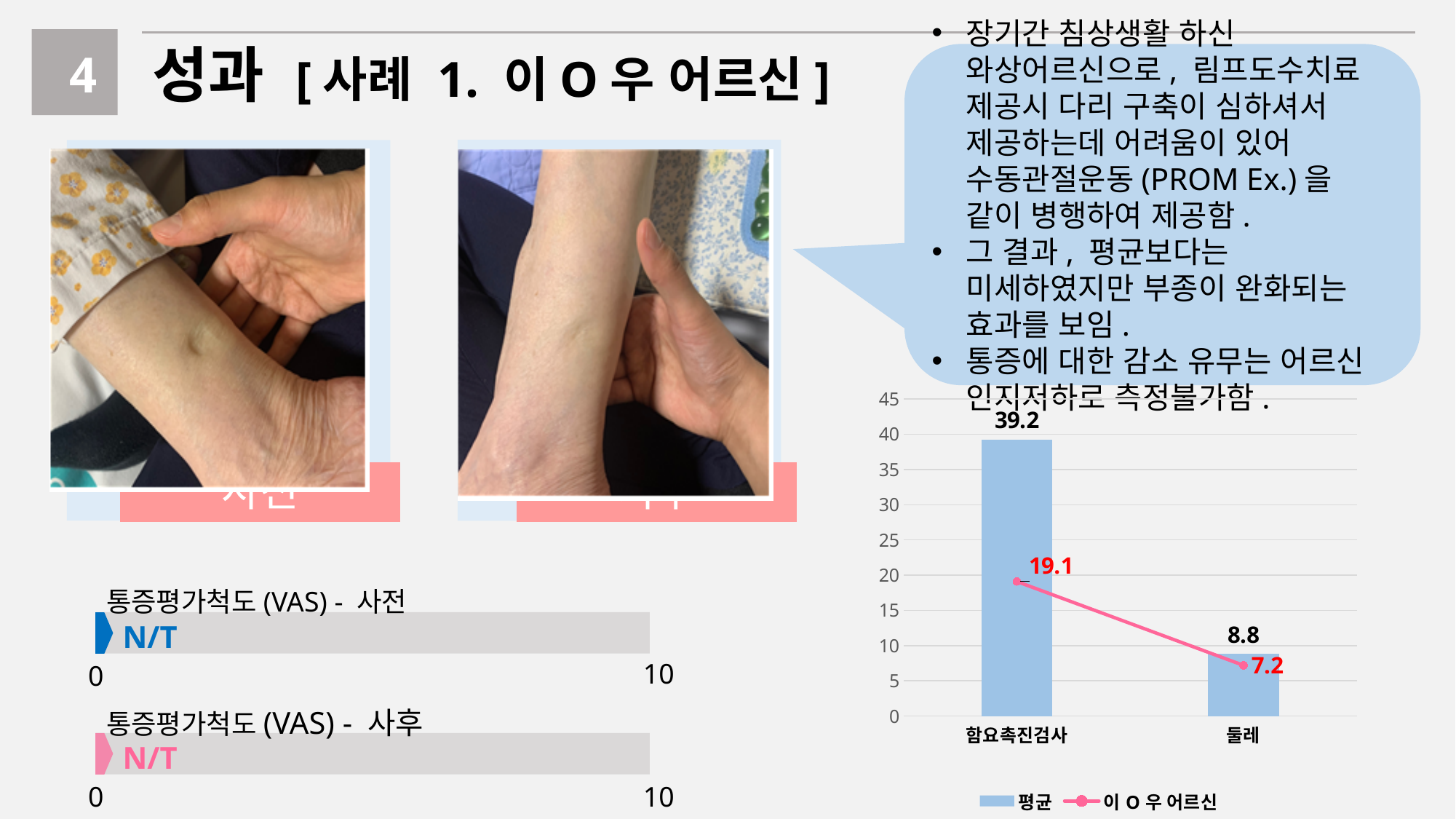
In the chart on the right, what is the 평균 value for 함요촉진검사? 39.2 In the chart on the right, what is the difference between the 평균 and 이 O 우 어르신 values for 둘레? 1.6 In the chart on the right, what is the 평균 value for 둘레? 8.8 In the chart on the right, which category has the higher 평균 value? 함요촉진검사 In the chart on the right, which category has the lower 이 O 우 어르신 value? 둘레 How many series does the legend of the chart on the right list? 2 In the chart on the right, what is the difference between the 평균 and 이 O 우 어르신 values for 함요촉진검사? 20.1 In the chart on the right, for 둘레, which is larger: the 평균 value or the 이 O 우 어르신 value? 평균 In the chart on the right, what is the 이 O 우 어르신 value for 둘레? 7.2 How many categories are shown on the x axis of the chart on the right? 2 In the chart on the right, does the 이 O 우 어르신 line rise or fall from 함요촉진검사 to 둘레? fall In the chart on the right, what is the 이 O 우 어르신 value for 함요촉진검사? 19.1